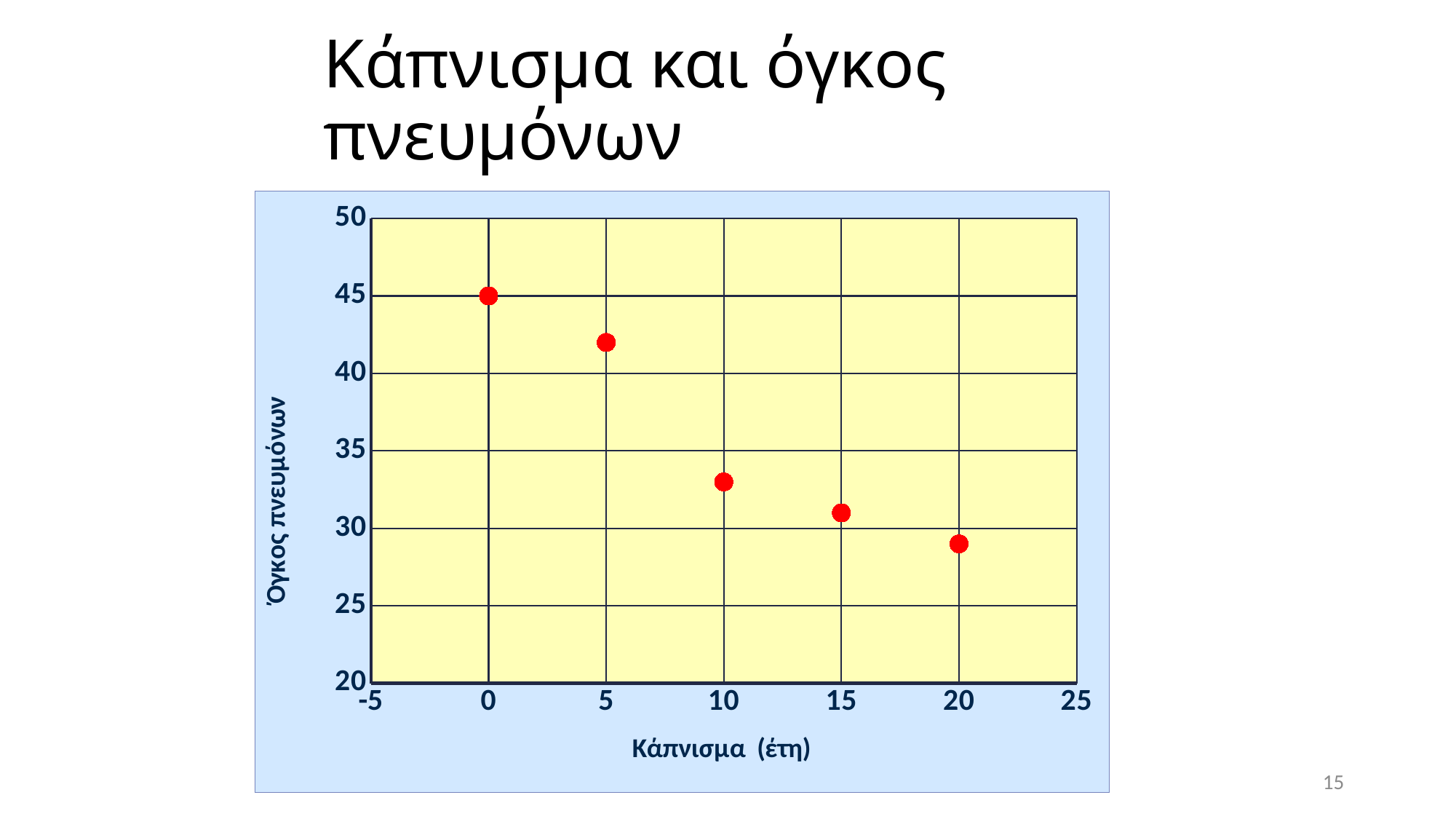
At which number of years of smoking is the lung volume highest? 0 What is the label of the x axis? Κάπνισμα (έτη) Is the lung volume value for 5 years of smoking greater or less than 40? greater What kind of chart is shown on the slide? scatter chart How many data points are plotted on the chart? 5 At which number of years of smoking is the lung volume lowest? 20 Is the lung volume value for 20 years of smoking greater or less than 30? less Is the lung volume value for 10 years of smoking greater or less than 35? less Which has the larger lung volume value: 5 years of smoking or 10 years of smoking? 5 years What is the lung volume (Όγκος πνευμόνων) value for 0 years of smoking? 45 Do the lung volume values rise or fall as the years of smoking increase along the x axis? fall